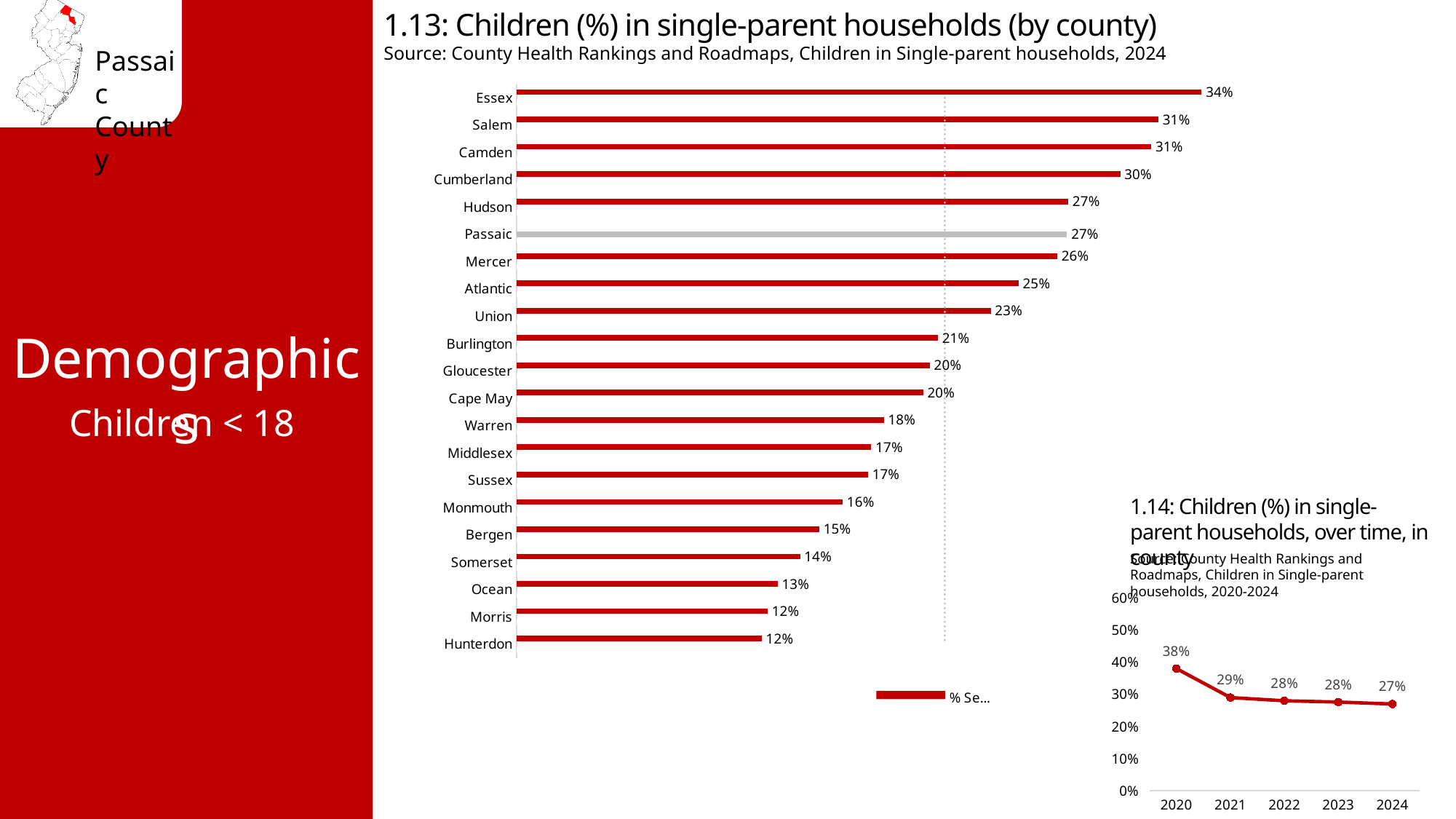
What kind of chart is chart 1.13 (Children (%) in single-parent households by county)? Bar chart In chart 1.14 (Children (%) in single-parent households over time), do the values rise or fall from 2020 to 2024? Fall In chart 1.13 (Children (%) in single-parent households by county), what is the value for Passaic? 27% In chart 1.13 (Children (%) in single-parent households by county), what is the value for Cumberland? 30% In chart 1.13 (Children (%) in single-parent households by county), which is larger, the value for Union or the value for Bergen? Union In chart 1.13 (Children (%) in single-parent households by county), how many counties are shown? 21 In chart 1.14 (Children (%) in single-parent households over time), what is the difference between the 2020 and 2021 values? 9% In chart 1.13 (Children (%) in single-parent households by county), what is the difference between Essex and Hunterdon? 22% In chart 1.14 (Children (%) in single-parent households over time), what is the value for 2020? 38% In chart 1.13 (Children (%) in single-parent households by county), which county has the highest value? Essex What kind of chart is chart 1.14 (Children (%) in single-parent households over time)? Line chart In chart 1.14 (Children (%) in single-parent households over time), what is the value for 2024? 27%